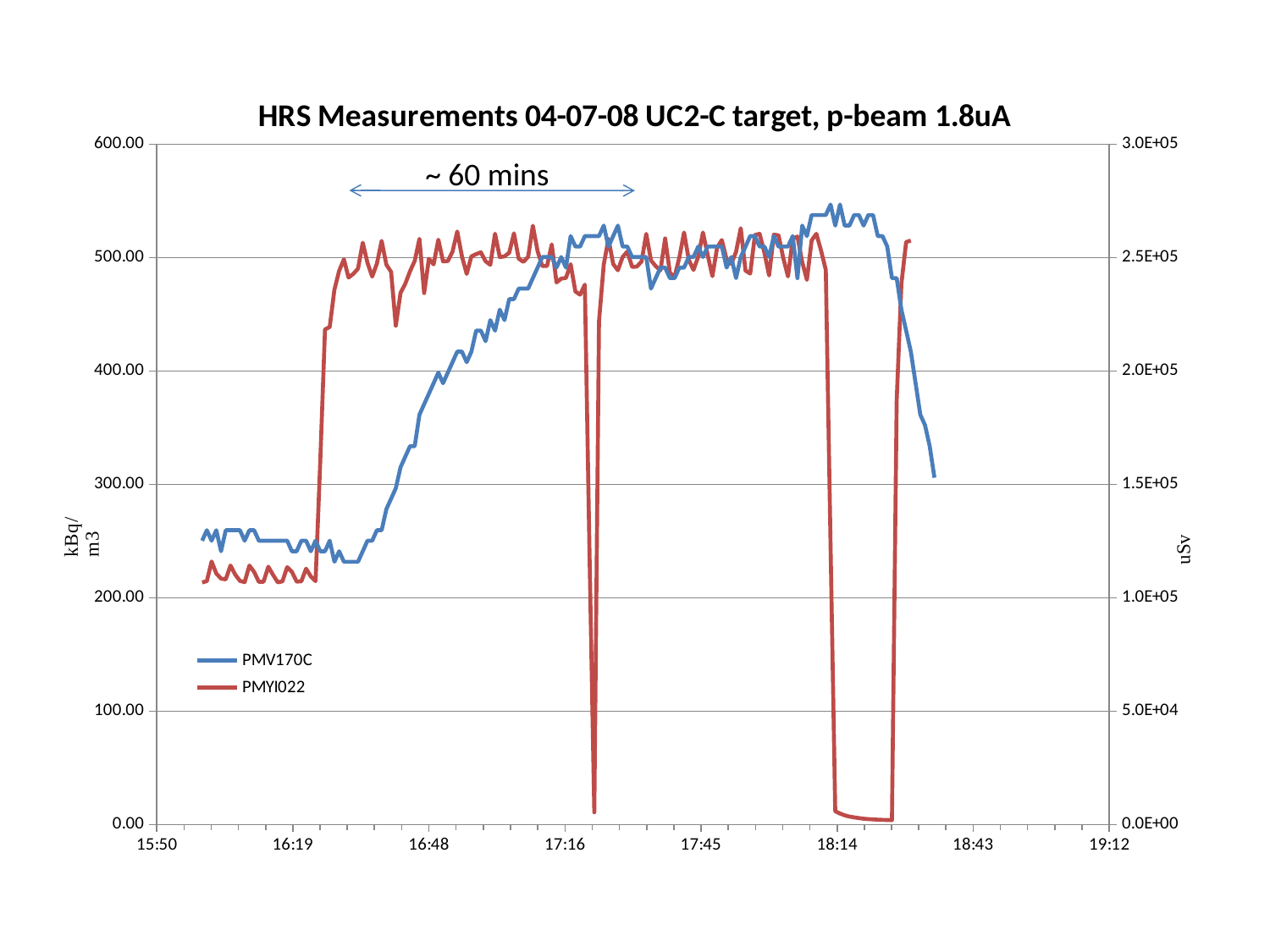
How many series does the legend list? 2 What are the names of the two series in the legend? PMV170C and PMYI022 Does the PMV170C line rise or fall after 18:14 toward the end of the plot? Fall Read against the left axis, is the PMV170C value at 17:45 greater or less than 400.00? greater At 16:48, which line is plotted higher on the chart, PMV170C or PMYI022? PMYI022 Does the PMV170C line rise or fall between 16:19 and 17:16? Rise Read against the left axis, is the PMV170C value at 16:19 greater or less than 300.00? less What is the title of the chart? HRS Measurements 04-07-08 UC2-C target, p-beam 1.8uA What kind of chart is shown on the slide? Line chart Does the PMYI022 line rise or fall between 16:19 and 16:48? Rise At 18:14, which line is plotted higher on the chart, PMV170C or PMYI022? PMV170C Read against the left axis, is the lowest point of the PMYI022 dip just after 17:16 greater or less than 100.00? less